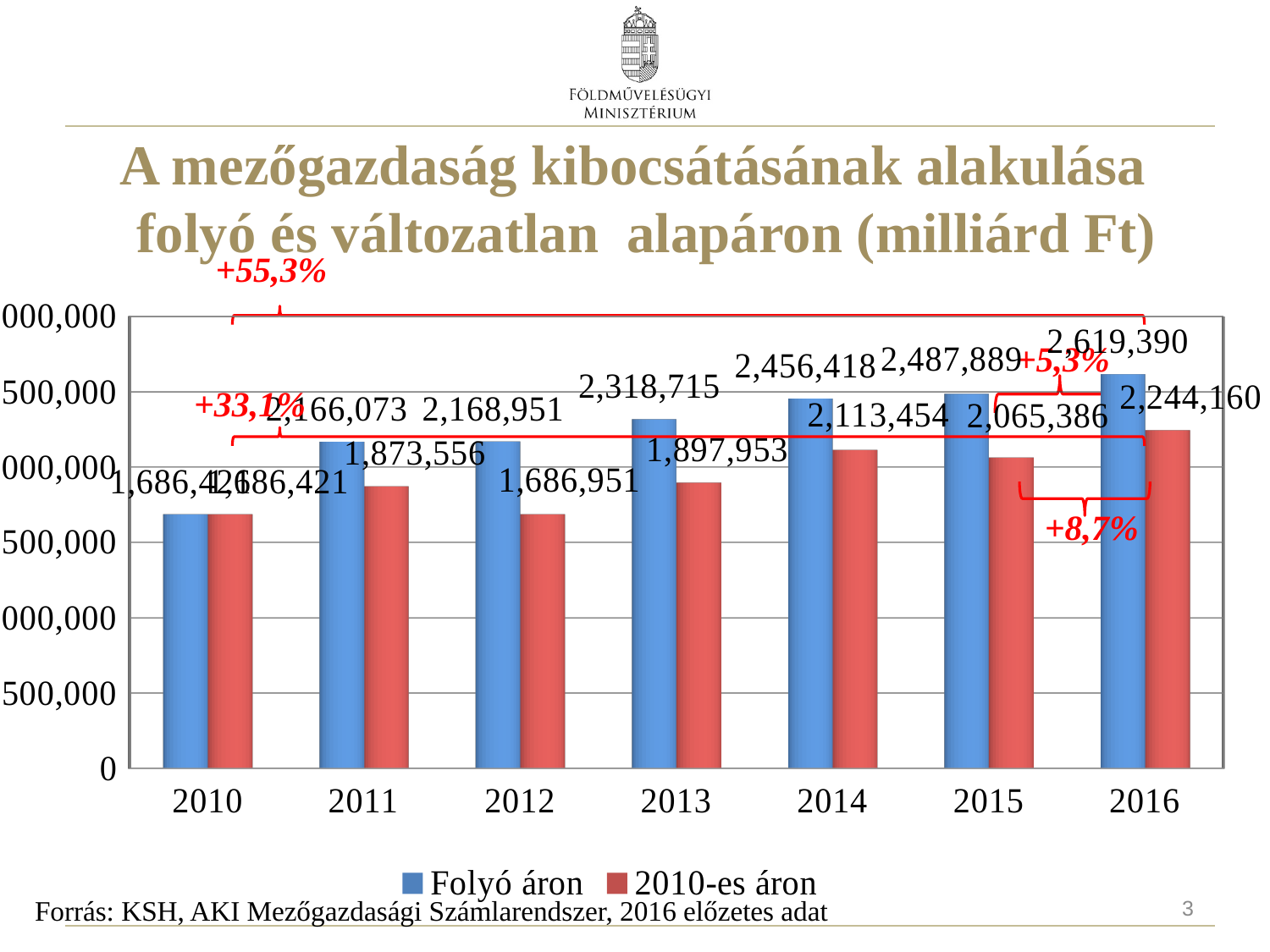
How many series does the legend list? 2 What is the value for Folyó áron in 2016? 2,619,390 What kind of chart is shown on the slide? bar chart Which is larger: the 2010-es áron value in 2014 or in 2015? 2014 Is the Folyó áron value for 2013 greater or less than 2,000,000? greater How many years are shown on the x axis? 7 What is the value for Folyó áron in 2014? 2,456,418 In which year is the Folyó áron value lowest? 2010 What is the value for 2010-es áron in 2013? 1,897,953 Do the Folyó áron values rise or fall from 2010 to 2016? rise What is the difference between the Folyó áron and 2010-es áron values in 2016? 375,230 In which year is the Folyó áron value highest? 2016